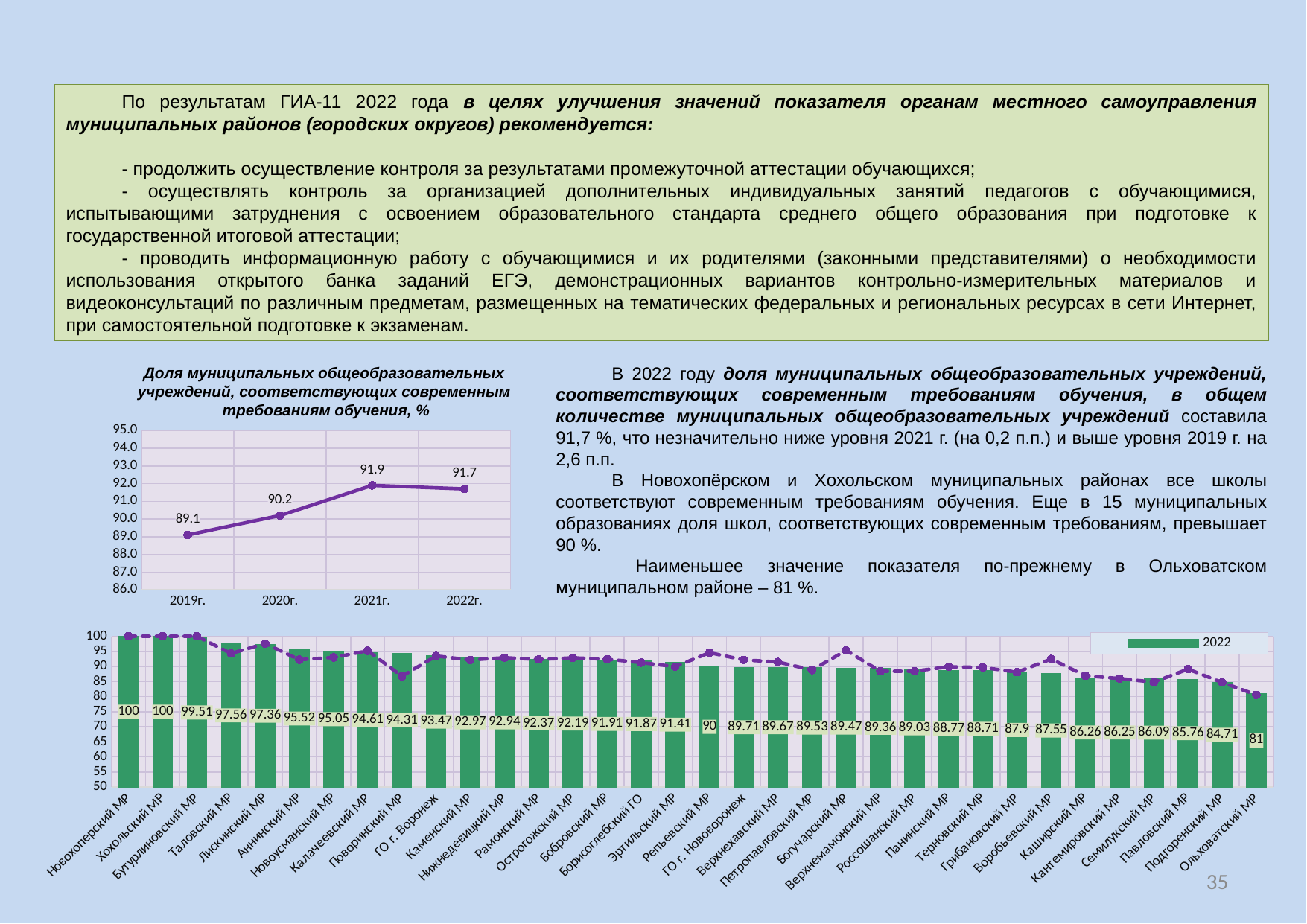
In the line chart at the top left, what is the difference between the values for 2021г. and 2022г.? 0.2 In the bar chart at the bottom of the slide, how many districts are shown? 34 In the line chart at the top left, which year has the lowest value? 2019г. In the bar chart at the bottom of the slide, what year does the legend entry for the green bars show? 2022 In the line chart at the top left, do the values rise or fall from 2019г. to 2021г.? rise In the line chart at the top left, which year has the highest value? 2021г. In the line chart at the top left, how many years are plotted? 4 In the bar chart at the bottom of the slide, which is larger: the value for Каширский МР or Павловский МР? Каширский МР In the bar chart at the bottom of the slide, what is the value for Таловский МР? 97.56 In the bar chart at the bottom of the slide, what is the difference between the values for Бутурлиновский МР and Таловский МР? 1.95 In the line chart titled "Доля муниципальных общеобразовательных учреждений, соответствующих современным требованиям обучения, %", what is the value for 2021г.? 91.9 In the bar chart at the bottom of the slide, which district has the lowest value? Ольховатский МР